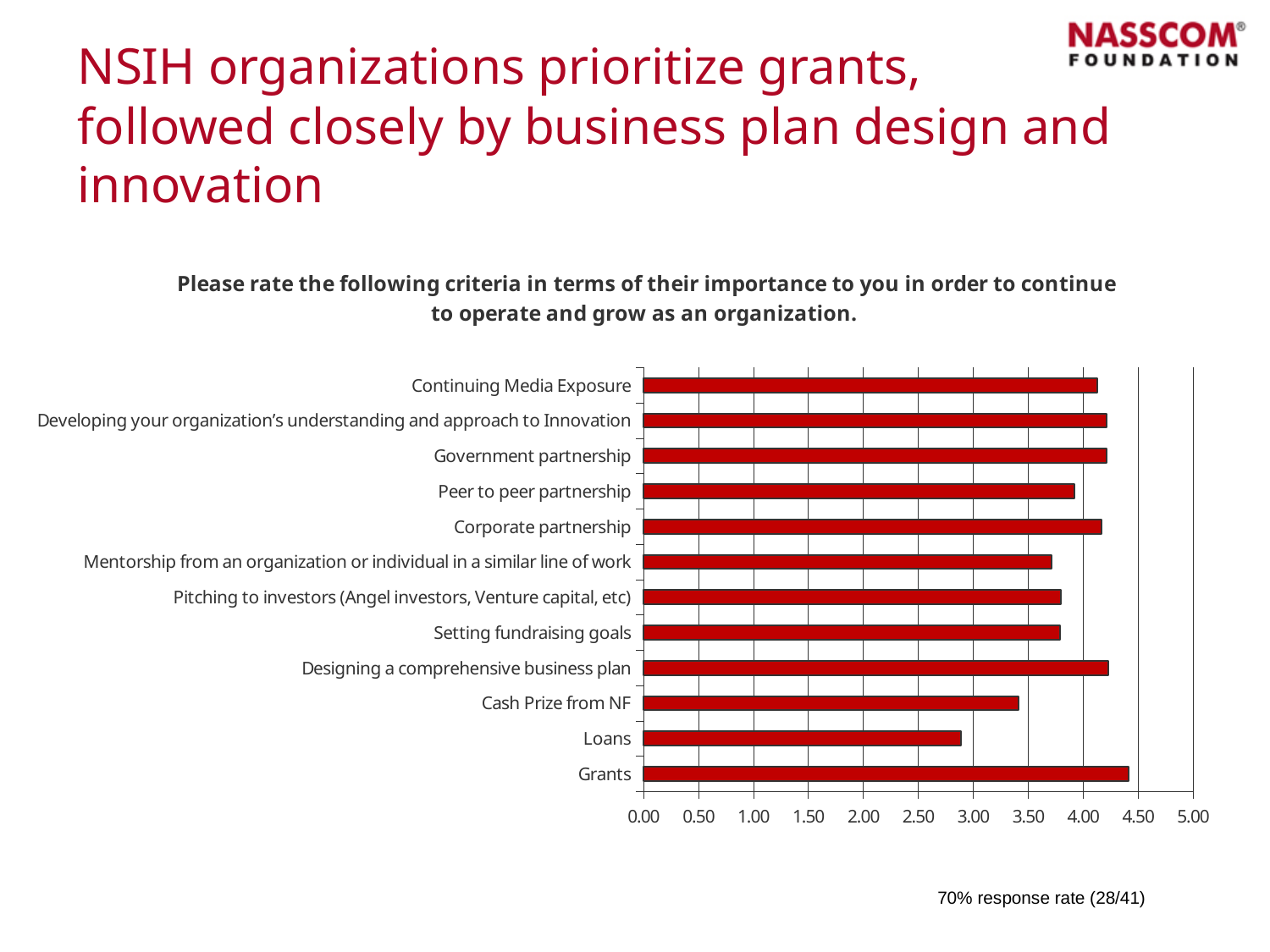
How many criteria are listed on the chart? 12 What kind of chart is shown on the slide? Bar chart Which is rated higher, Cash Prize from NF or Loans? Cash Prize from NF Is the value for Loans greater or less than 3.00? less Is the value for Continuing Media Exposure greater or less than 4.00? greater Is the value for Mentorship from an organization or individual in a similar line of work greater or less than 4.00? less Which is rated higher, Corporate partnership or Peer to peer partnership? Corporate partnership Which criterion has the highest rating? Grants Which criterion has the lowest rating? Loans What colour are the bars in the chart? Red